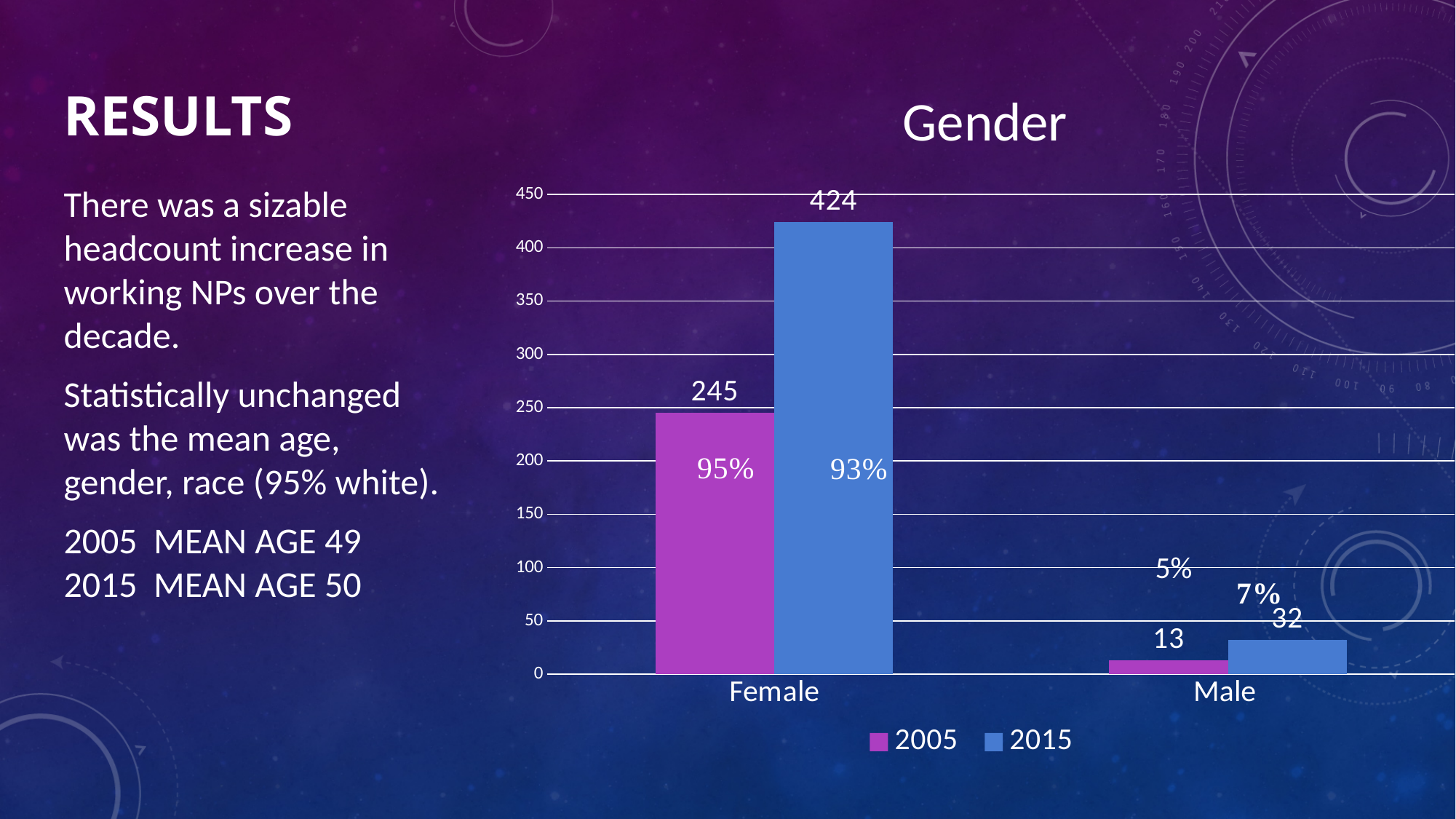
What is the value for Female in 2015? 424 Which category has the lowest value in the 2005 series? Male How many categories are shown on the x axis? 2 Which is larger, the Female value for 2005 or the Female value for 2015? 2015 What kind of chart is shown? Bar chart What is the difference between the Male values for 2015 and 2005? 19 What is the value for Male in 2015? 32 How many series does the legend list? 2 What is the difference between the Female values for 2015 and 2005? 179 Which category has the highest value in the 2015 series? Female What is the value for Male in 2005? 13 What is the value for Female in 2005? 245